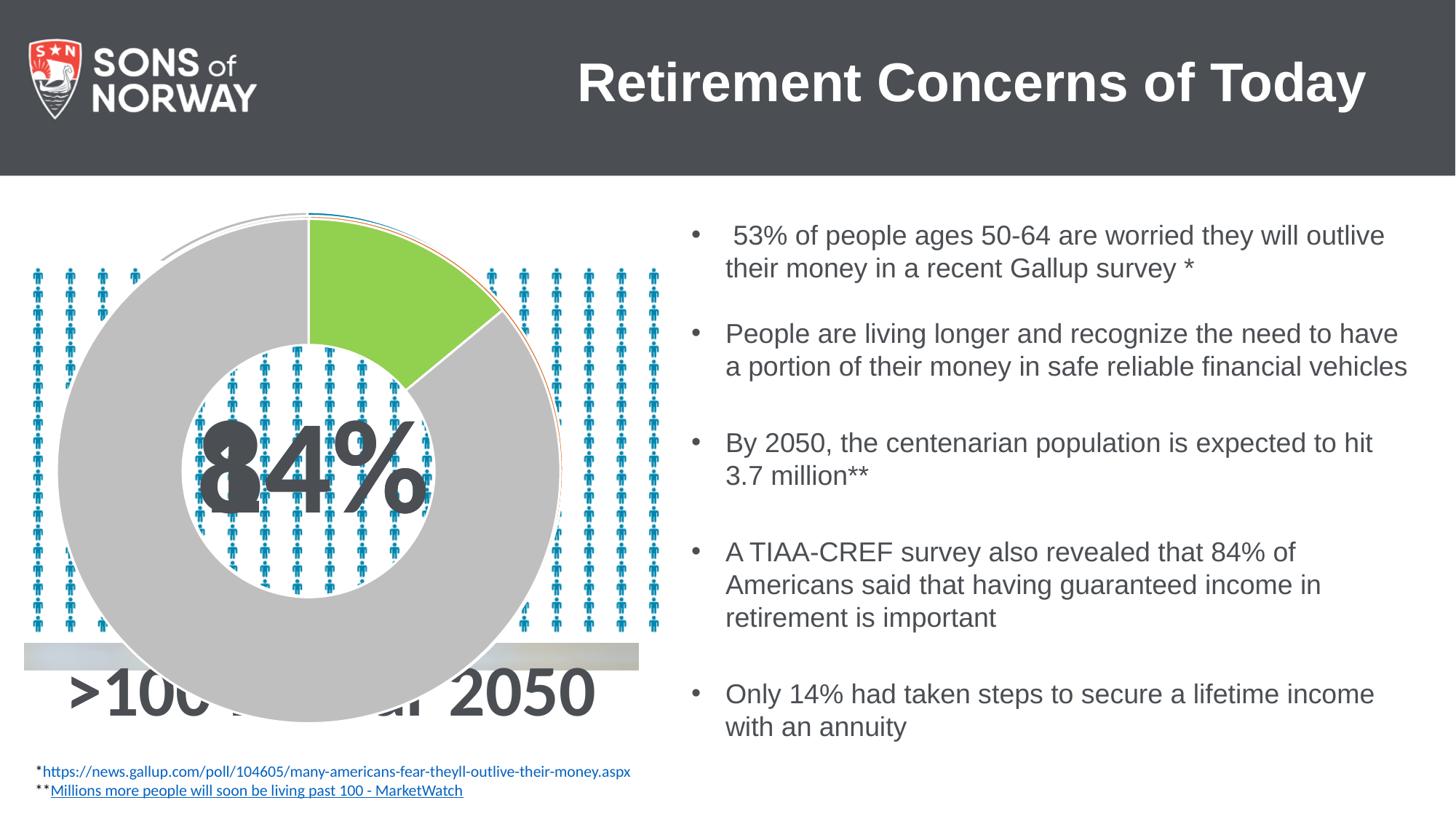
In the donut chart on the left of the slide, which colour is the largest slice? gray What colours are the two slices of the donut chart on the left of the slide? green and gray In the donut chart on the left of the slide, which colour is the smaller slice? green In the donut chart on the left of the slide, which slice is larger, the green one or the gray one? the gray one What kind of chart is shown on the left of the slide? pie chart (donut) How many slices does the donut chart on the left of the slide have? 2